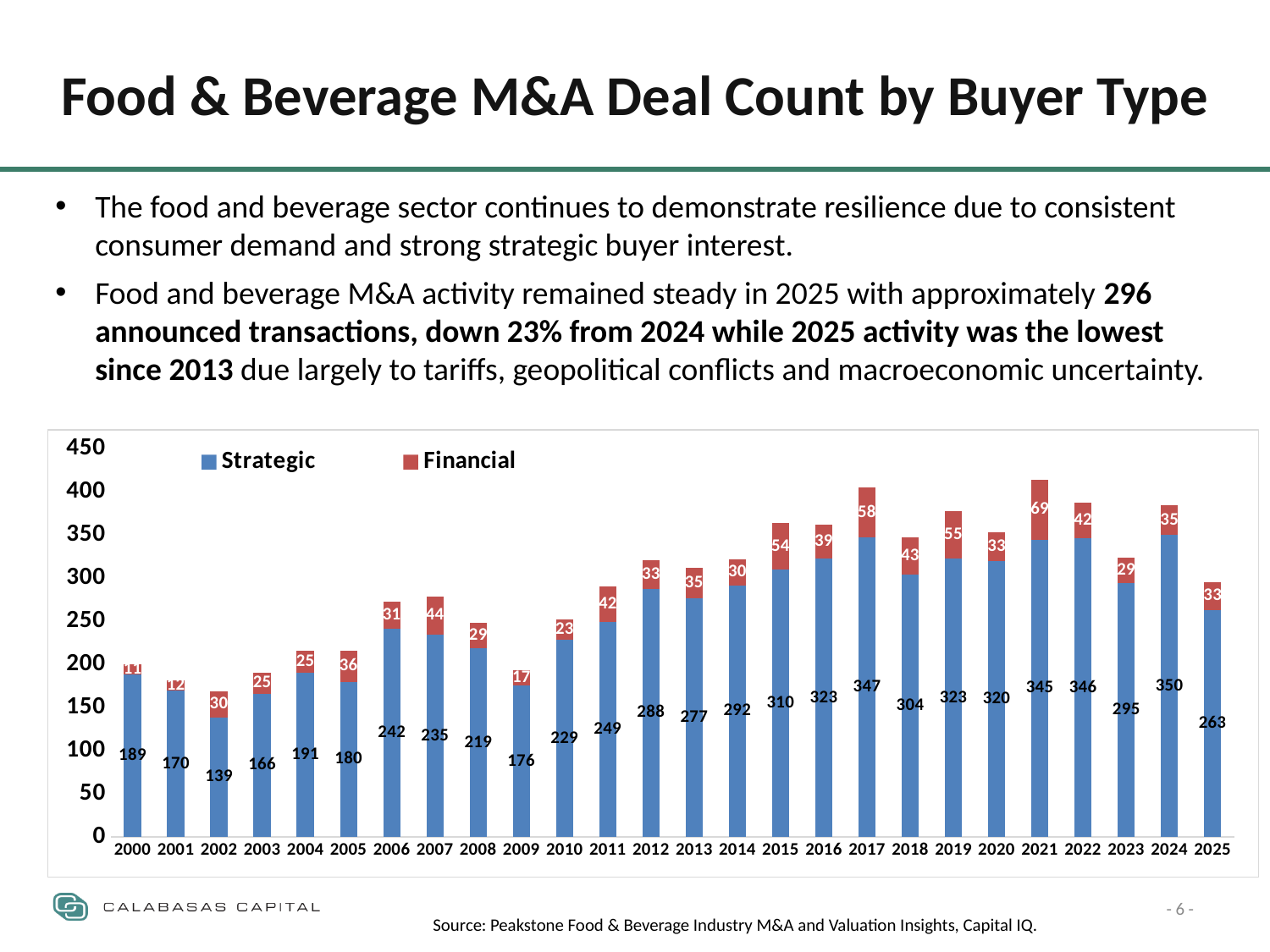
What is the Financial deal count for 2021? 69 How many series does the legend list? 2 What is the difference between the Strategic deal counts for 2024 and 2025? 87 What is the Strategic deal count for 2002? 139 What type of chart is shown on the slide? Stacked bar chart What is the Strategic deal count for 2025? 263 Which year has the lowest Strategic deal count? 2002 What is the total deal count (Strategic plus Financial) for 2025? 296 Which is larger, the Financial deal count for 2017 or for 2019? 2017 Which year has the highest Strategic deal count? 2024 What is the total deal count (Strategic plus Financial) for 2021? 414 How many years are shown on the x axis? 26